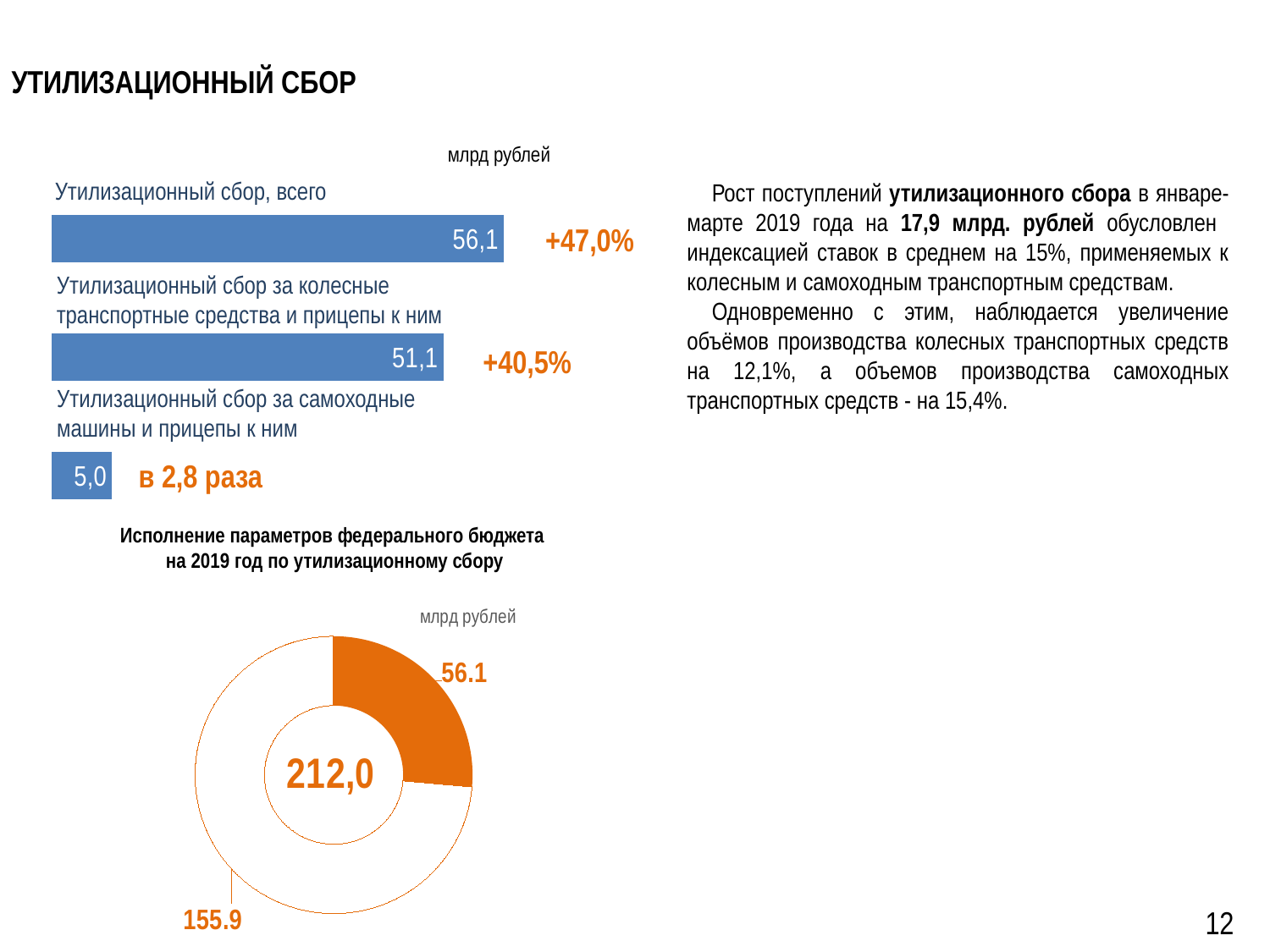
In the top bar chart, what is the difference between the value for 'Утилизационный сбор, всего' and the value for 'Утилизационный сбор за колесные транспортные средства и прицепы к ним'? 5,0 In the chart titled 'Исполнение параметров федерального бюджета на 2019 год по утилизационному сбору', what total value is shown in the centre of the doughnut? 212,0 In the top bar chart, which category has the highest value? Утилизационный сбор, всего What type of chart is the chart titled 'Исполнение параметров федерального бюджета на 2019 год по утилизационному сбору'? doughnut chart In the top bar chart, which category has the lowest value? Утилизационный сбор за самоходные машины и прицепы к ним How many bars are in the top bar chart? 3 In the top bar chart, what growth percentage is shown next to the bar for 'Утилизационный сбор, всего'? +47,0% In the chart titled 'Исполнение параметров федерального бюджета на 2019 год по утилизационному сбору', what is the value of the orange segment? 56.1 In the top bar chart, what is the value for 'Утилизационный сбор за колесные транспортные средства и прицепы к ним'? 51,1 In the top bar chart, what is the value for 'Утилизационный сбор, всего'? 56,1 In the top bar chart, what is the value for 'Утилизационный сбор за самоходные машины и прицепы к ним'? 5,0 What type of chart is the top chart on the slide? bar chart